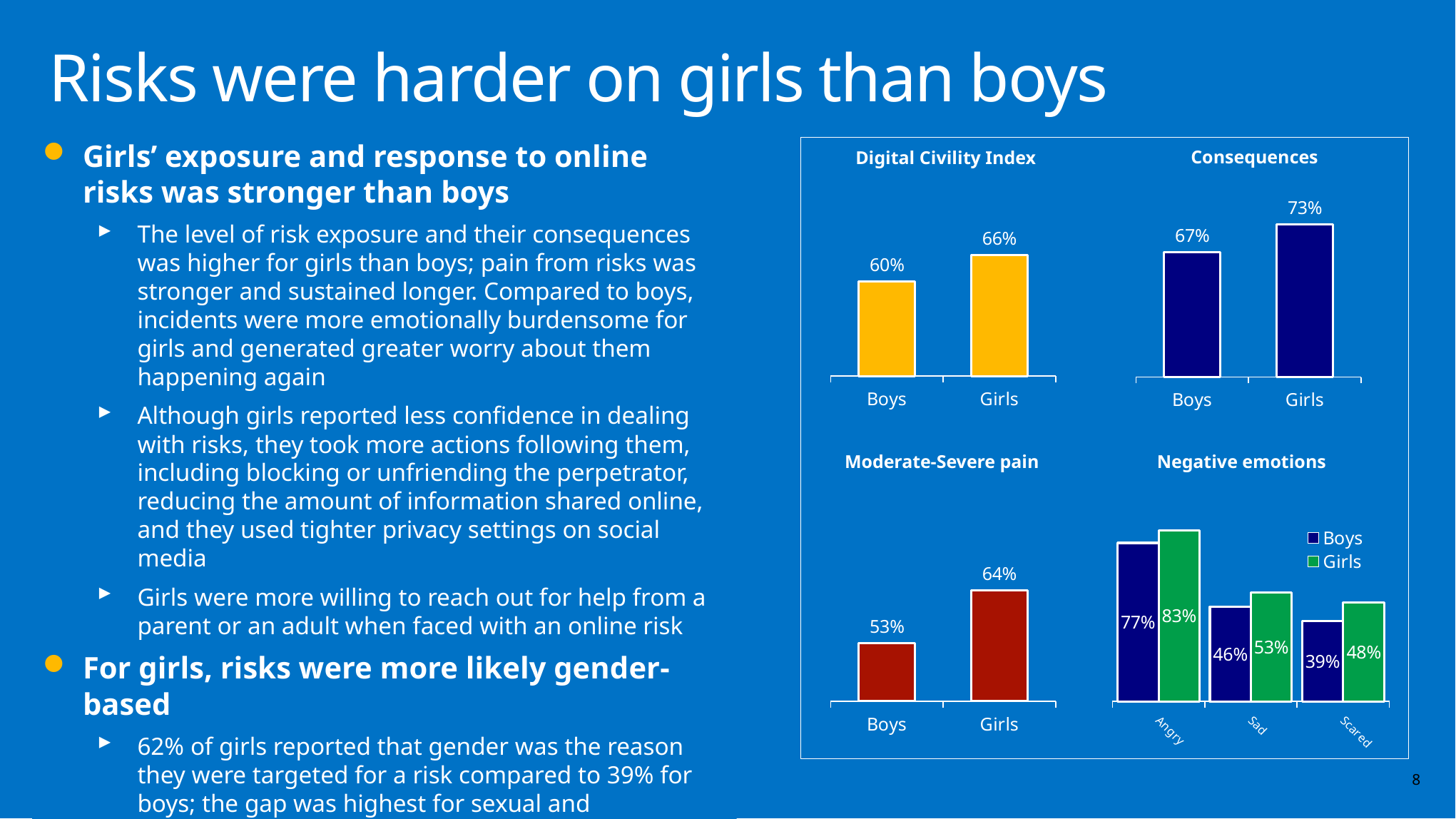
In the Consequences chart, what is the value for Girls? 73% In the Moderate-Severe pain chart, which category has the higher value, Boys or Girls? Girls In the Consequences chart, what is the difference between the Girls and Boys values? 6% In the Digital Civility Index chart, what is the value for Girls? 66% In the Negative emotions chart, what is the difference between the Girls and Boys values for Sad? 7% In the Moderate-Severe pain chart, what is the value for Boys? 53% How many series does the legend of the Negative emotions chart list? 2 In the Negative emotions chart, what is the Girls value for Angry? 83% In the Negative emotions chart, which emotion has the lowest Boys value? Scared In the Negative emotions chart, what is the Boys value for Scared? 39% In the Digital Civility Index chart, what is the value for Boys? 60% What kind of chart is the Consequences chart? Bar chart